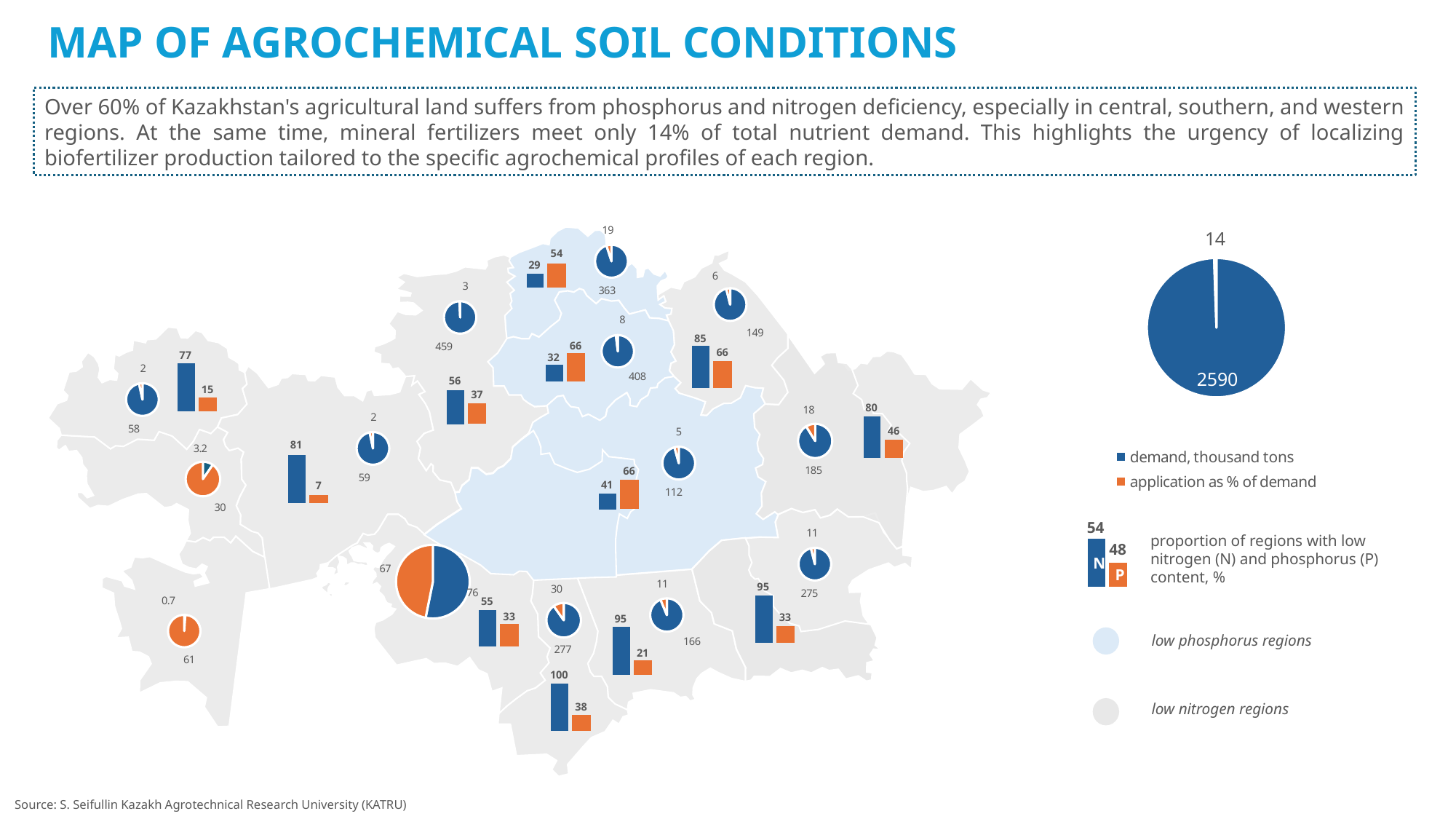
In the bar pair at the top of the map labelled 29 and 54, which is larger, the N value or the P value? P In the large pie chart at the top right of the slide, what value is shown for application as % of demand? 14 What kind of chart is the large chart at the top right of the slide? pie chart In the largest pie chart on the map (lower left of centre), what value is labelled next to the orange slice? 67 In the large pie chart at the top right of the slide, what value is shown for demand, thousand tons? 2590 Among the blue-and-orange bar pairs on the map, what is the lowest value shown for P (orange bar)? 7 In the legend key for 'proportion of regions with low nitrogen (N) and phosphorus (P) content, %', what value is shown above the N bar? 54 What colour is used in the legend for 'application as % of demand'? orange Among the blue-and-orange bar pairs on the map, what is the highest value shown for N (blue bar)? 100 In the bar pair at the bottom centre of the map labelled 100 and 38, what is the difference between the N and P values? 62 How many entries does the legend with 'demand, thousand tons' list? 2 In the largest pie chart on the map (lower left of centre), what value is labelled next to the blue slice? 76